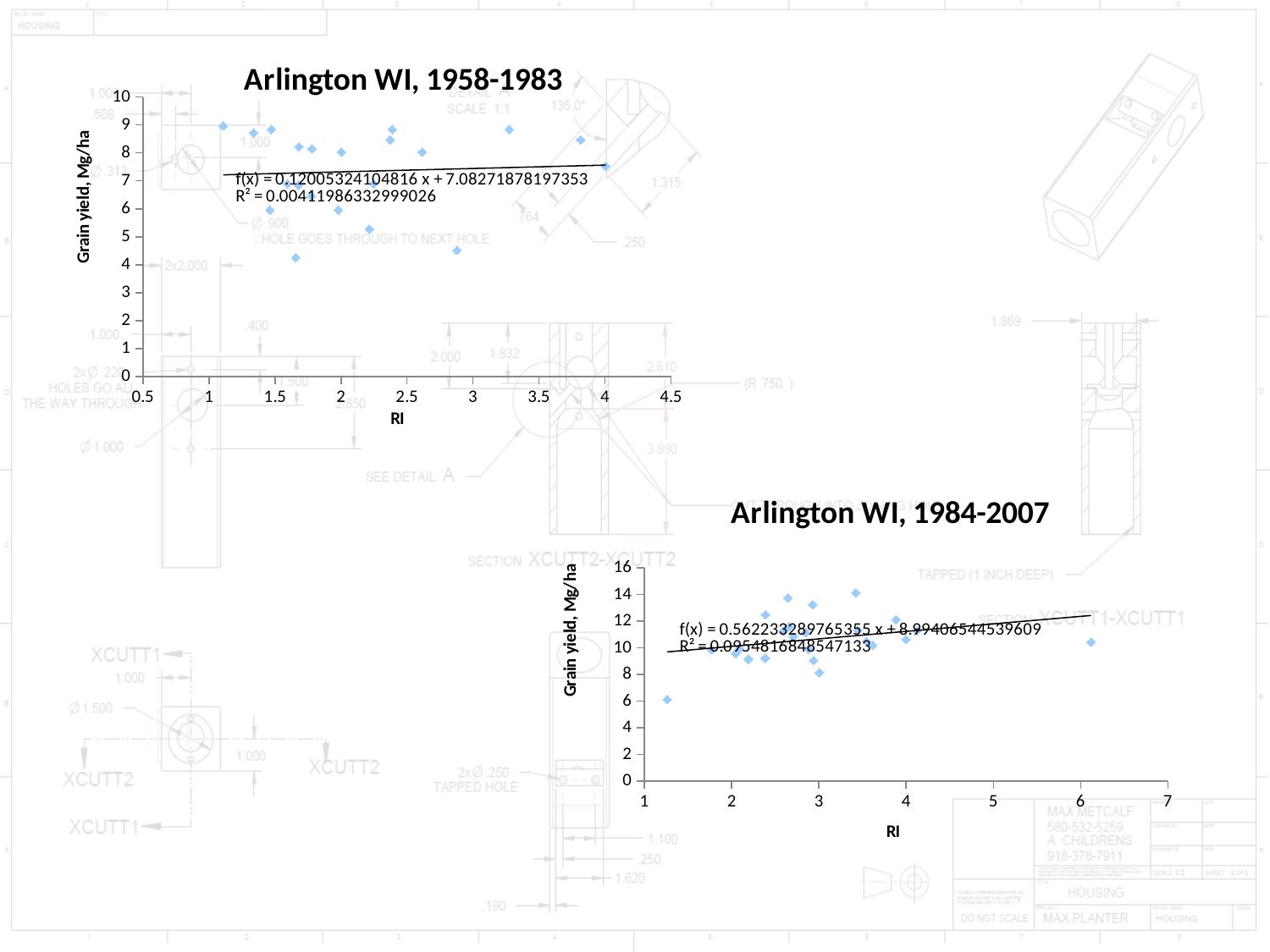
In the 'Arlington WI, 1958-1983' chart, is the lowest grain yield point greater or less than 5 Mg/ha? less In the 'Arlington WI, 1984-2007' chart, does the fitted trend line rise or fall as RI increases? rise In the 'Arlington WI, 1958-1983' chart, does the fitted trend line rise or fall as RI increases? rise In the 'Arlington WI, 1984-2007' chart, what R² value is printed for the trend line? 0.0954816848547133 In the 'Arlington WI, 1984-2007' chart, what is the intercept of the fitted line f(x) shown on the chart? 8.99406544539609 In the 'Arlington WI, 1958-1983' chart, what R² value is printed for the trend line? 0.00411986332999026 In the 'Arlington WI, 1958-1983' chart, what is the slope of the fitted line f(x) shown on the chart? 0.12005324104816 What kind of chart is the 'Arlington WI, 1958-1983' chart? scatter chart In the 'Arlington WI, 1984-2007' chart, is the highest grain yield point greater or less than 12 Mg/ha? greater In the 'Arlington WI, 1958-1983' chart, what is the y-axis label? Grain yield, Mg/ha What is the title of the lower-right chart? Arlington WI, 1984-2007 Which chart reports the larger R² value, 'Arlington WI, 1958-1983' or 'Arlington WI, 1984-2007'? Arlington WI, 1984-2007